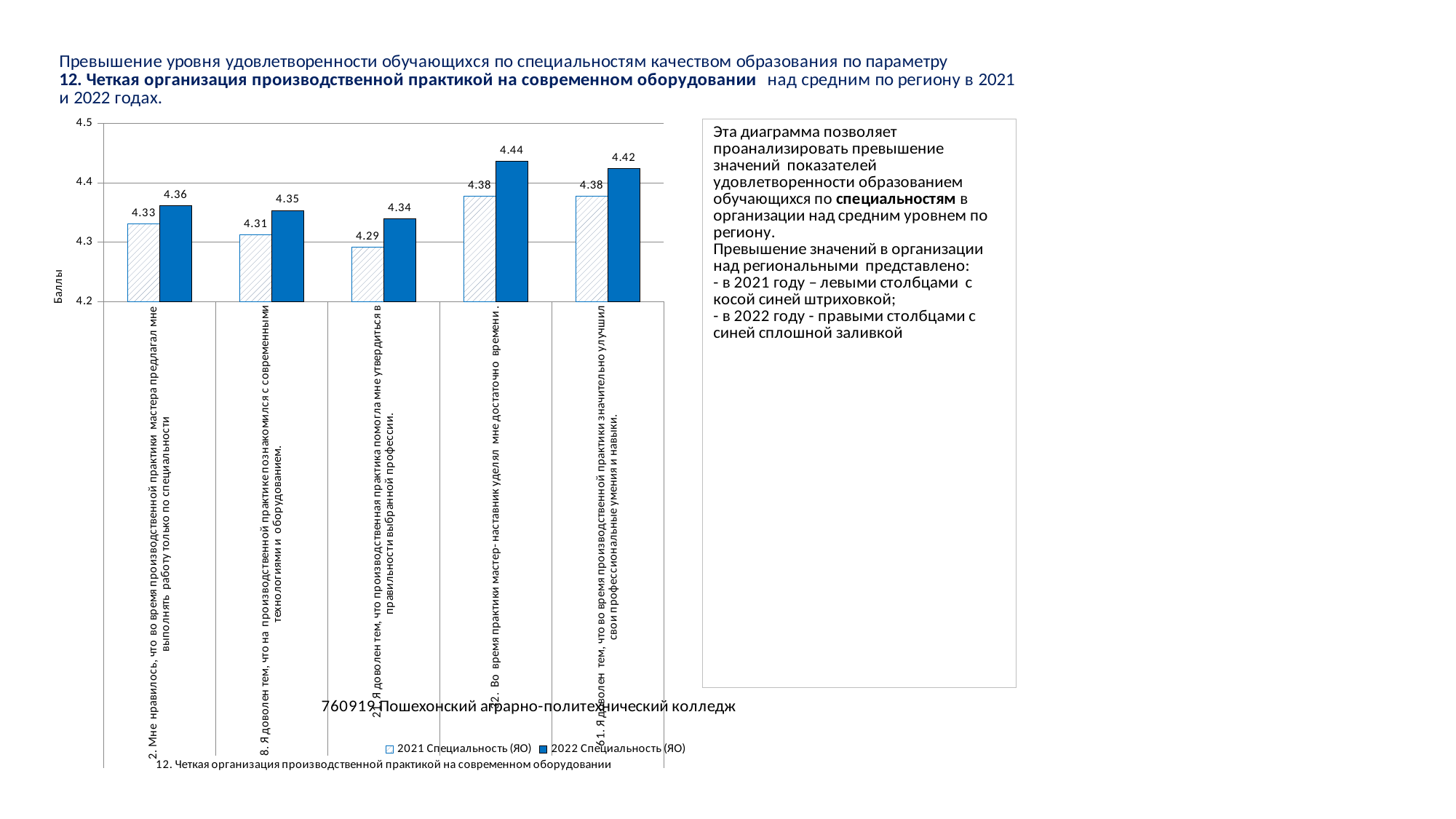
What is the value of the 2021 Специальность (ЯО) series for statement 8 (Я доволен тем, что на производственной практике познакомился с современными технологиями и оборудованием)? 4.31 What type of chart is shown on the slide? bar chart How many categories (statements) are plotted on the x axis? 5 What is the difference between the 2022 and 2021 values for statement 22 (Во время практики мастер-наставник уделял мне достаточно времени)? 0.06 What is the label of the vertical axis? Баллы How many series does the legend list? 2 Which statement has the lowest value in the 2021 Специальность (ЯО) series? 21. Я доволен тем, что производственная практика помогла мне утвердиться в правильности выбранной профессии Which is larger for statement 61 (Я доволен тем, что во время производственной практики значительно улучшил свои профессиональные умения и навыки): the 2021 value or the 2022 value? 2022 value (4.42) Which statement has the highest value in the 2022 Специальность (ЯО) series? 32. Во время практики мастер-наставник уделял мне достаточно времени What is the value of the 2021 Специальность (ЯО) series for statement 21 (Я доволен тем, что производственная практика помогла мне утвердиться в правильности выбранной профессии)? 4.29 Is the 2022 Специальность (ЯО) value for statement 2 (Мне нравилось, что во время производственной практики мастер предлагал мне выполнять работу только по специальности) greater or less than 4.3? greater What is the value of the 2022 Специальность (ЯО) series for statement 22 (Во время практики мастер-наставник уделял мне достаточно времени)? 4.44